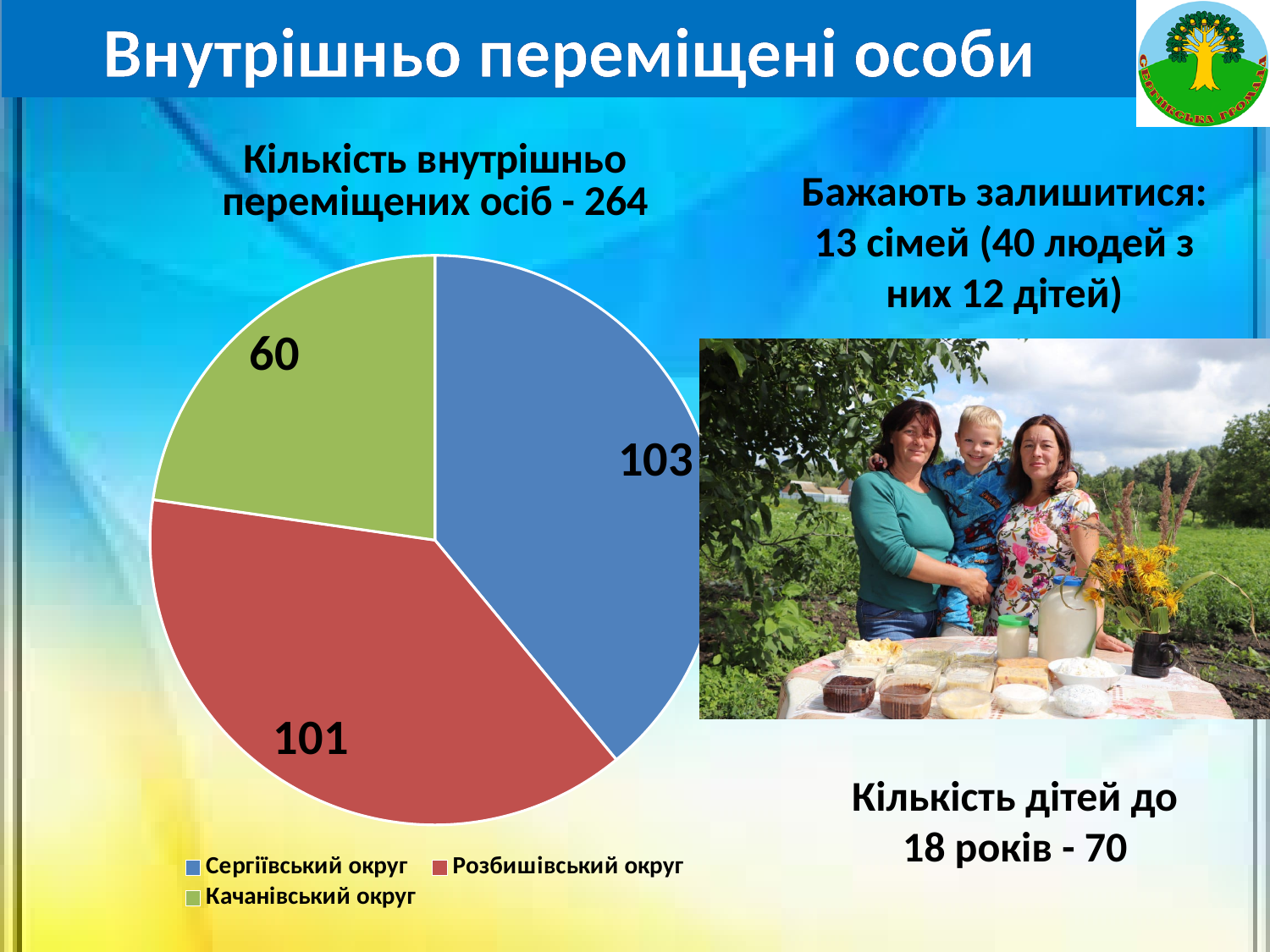
How many entries does the legend of the pie chart list? 3 Which district has the largest slice in the pie chart? Сергіївський округ Which district has the smallest slice in the pie chart? Качанівський округ How many slices does the pie chart have? 3 What is the difference between the values for Сергіївський округ and Качанівський округ? 43 What is the value for Розбишівський округ in the pie chart? 101 What is the title of the pie chart? Кількість внутрішньо переміщених осіб - 264 What is the total of all slices in the pie chart? 264 What is the value for Качанівський округ in the pie chart? 60 What is the value for Сергіївський округ in the pie chart? 103 Which is larger in the pie chart: Розбишівський округ or Качанівський округ? Розбишівський округ What kind of chart is shown on the slide? pie chart